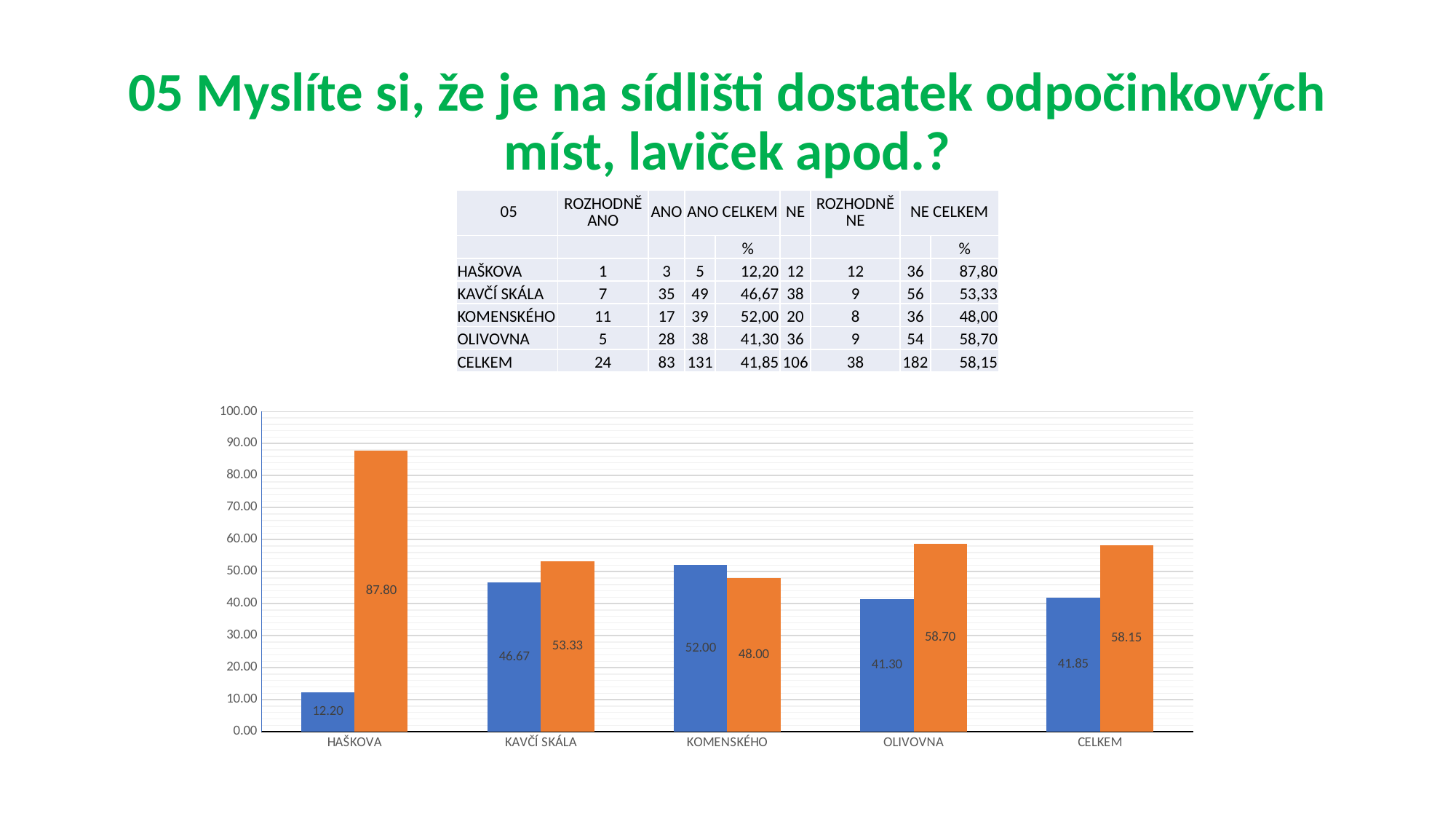
For KOMENSKÉHO, which bar is larger, the blue one or the orange one? the blue one What is the value of the orange bar for OLIVOVNA? 58.70 What is the value of the blue bar for HAŠKOVA? 12.20 Which category has the lowest blue bar? HAŠKOVA Is the value of the orange bar for KAVČÍ SKÁLA greater or less than 50.00? greater How many categories are shown on the x axis of the chart? 5 What kind of chart is shown on the slide? bar chart What is the value of the blue bar for CELKEM? 41.85 What is the difference between the orange bar and the blue bar for HAŠKOVA? 75.60 Which category has the highest orange bar? HAŠKOVA What is the difference between the orange bar and the blue bar for KAVČÍ SKÁLA? 6.66 Which category has the highest blue bar? KOMENSKÉHO